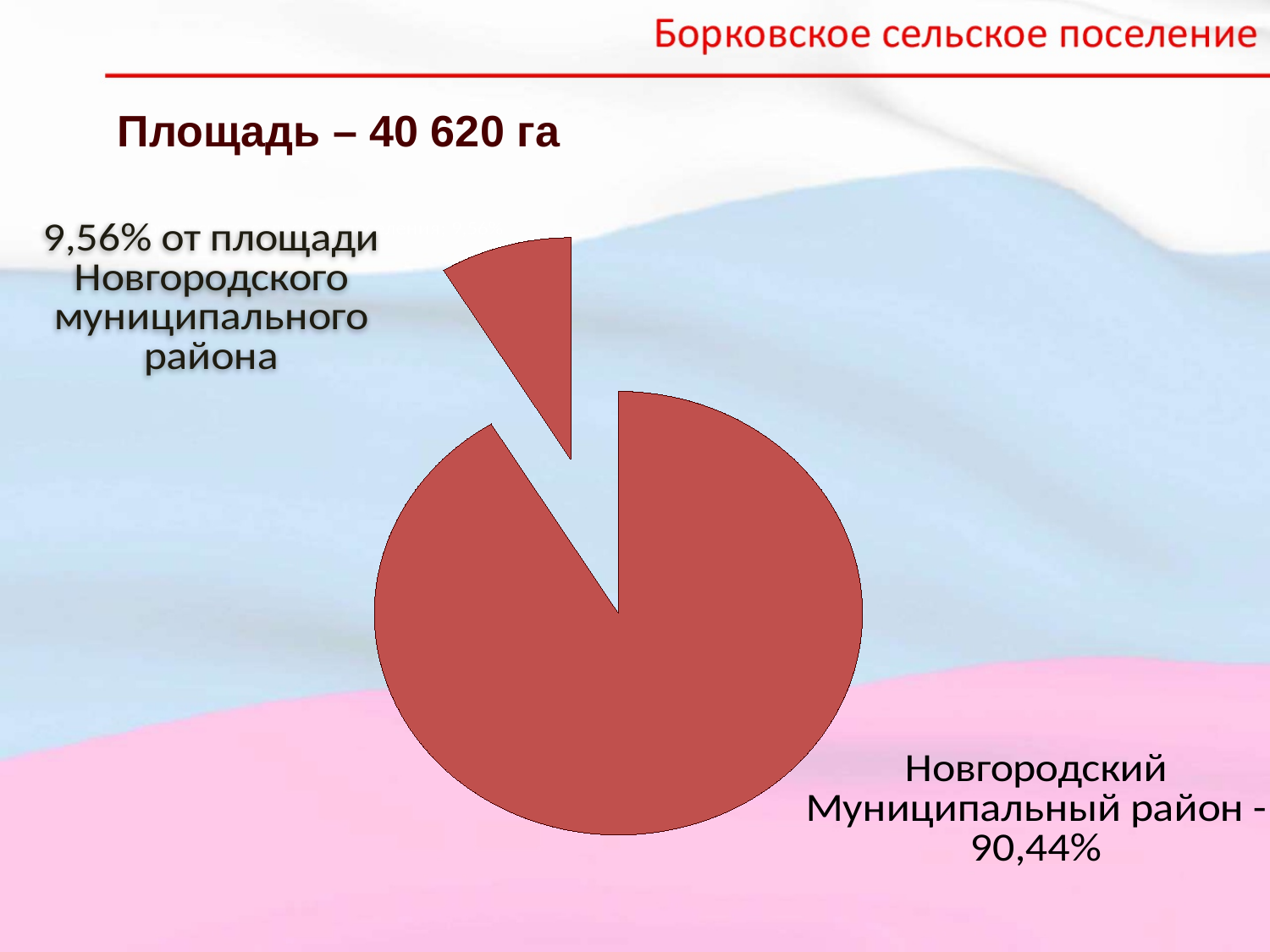
Which is larger: the slice labelled 90,44% or the slice labelled 9,56%? the slice labelled 90,44% Which slice of the pie is the largest? Новгородский Муниципальный район (90,44%) Is the share of the small separated slice greater or less than 10%? less How many slices does the pie chart have? 2 What kind of chart is shown on the slide? pie chart Which slice of the pie is the smallest? the 9,56% slice (share of the Новгородский муниципальный район area) What share of the pie does the small separated slice represent? 9,56% What share of the pie is labelled for Новгородский Муниципальный район? 90,44% What colour are the slices of the pie chart? red What is the difference in percentage points between the 90,44% slice and the 9,56% slice? 80,88 What do the two pie slices add up to? 100% What area (Площадь) is stated on the slide above the chart? 40 620 га